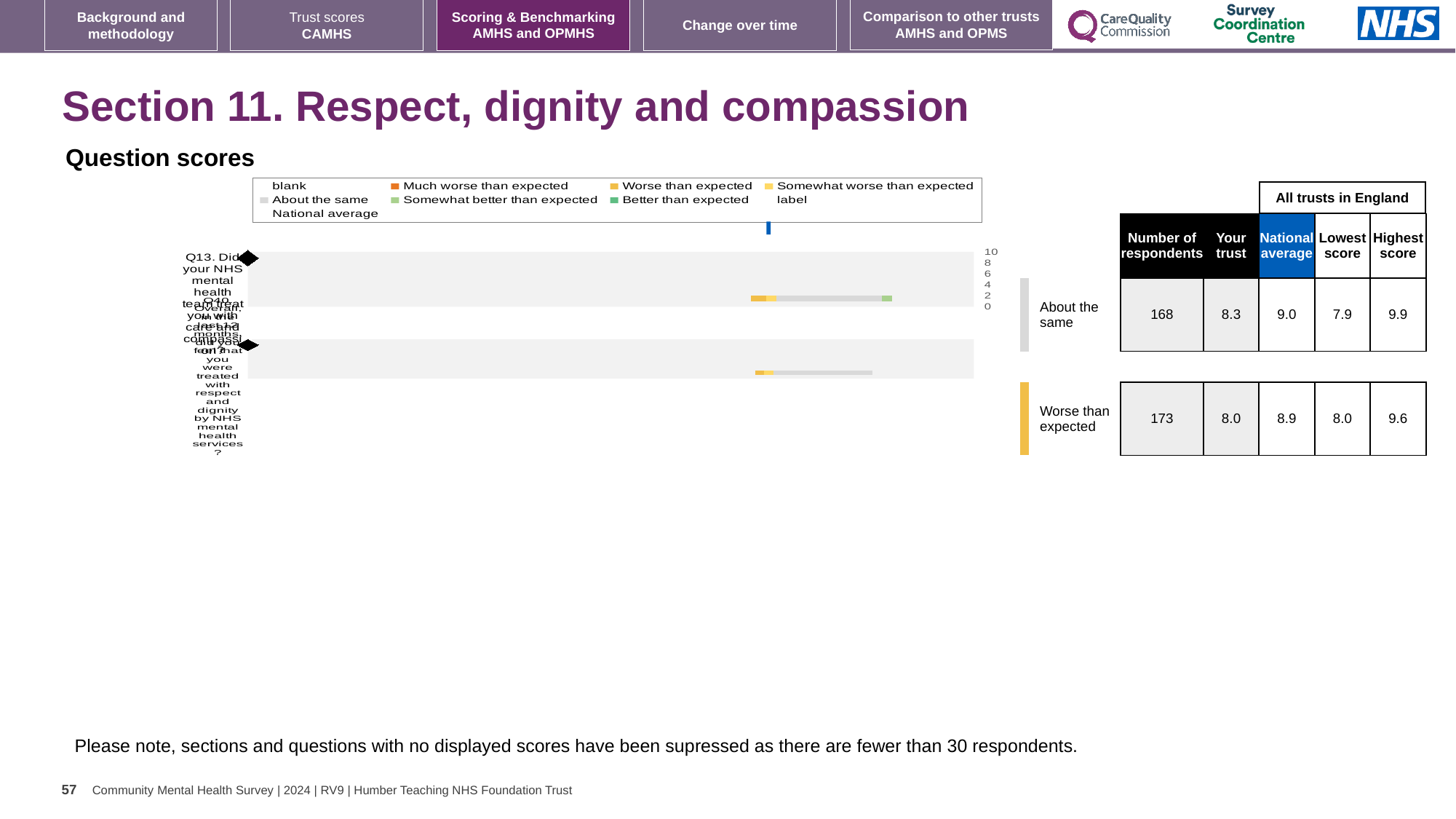
In the table beside the chart, what is the number of respondents for the 'About the same' row? 168 What is the title shown above the chart? Question scores What kind of chart is shown under 'Question scores'? Bar chart For the 'About the same' row, what is the difference between the highest score and the lowest score? 2.0 In the table beside the chart, what is the highest score for the 'Worse than expected' row? 9.6 What colour is the 'Much worse than expected' entry in the chart legend? Orange For the 'About the same' row, which is larger: the 'Your trust' score or the national average? National average Which row has more respondents, 'About the same' or 'Worse than expected'? Worse than expected In the table beside the chart, what is the 'Your trust' score for the 'Worse than expected' row? 8.0 In the table beside the chart, what is the national average for the 'About the same' row? 9.0 How many question rows (categories) are plotted in the 'Question scores' chart? 2 What is the maximum value shown on the chart's score axis? 10